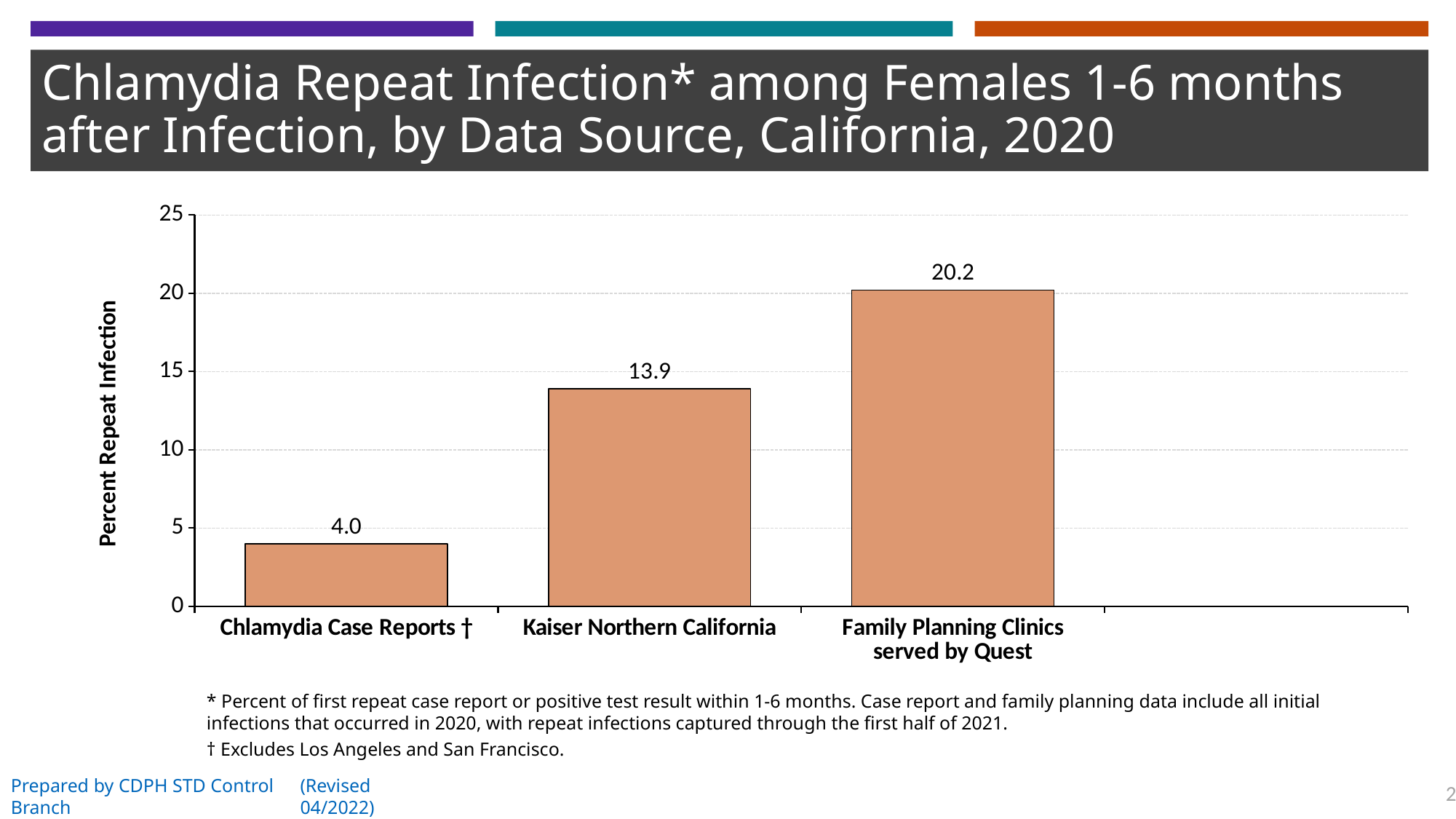
Which data source has the highest percent repeat infection? Family Planning Clinics served by Quest What is the percent repeat infection for Family Planning Clinics served by Quest? 20.2 What is the label of the y axis? Percent Repeat Infection Which has a higher percent repeat infection, Kaiser Northern California or Chlamydia Case Reports? Kaiser Northern California Is the value for Family Planning Clinics served by Quest greater or less than 20? greater What is the percent repeat infection for Kaiser Northern California? 13.9 Which data source has the lowest percent repeat infection? Chlamydia Case Reports What is the percent repeat infection for Chlamydia Case Reports? 4.0 What kind of chart is shown on the slide? Bar chart What is the difference in percent repeat infection between Family Planning Clinics served by Quest and Kaiser Northern California? 6.3 How many data sources are shown in the chart? 3 What is the difference in percent repeat infection between Kaiser Northern California and Chlamydia Case Reports? 9.9